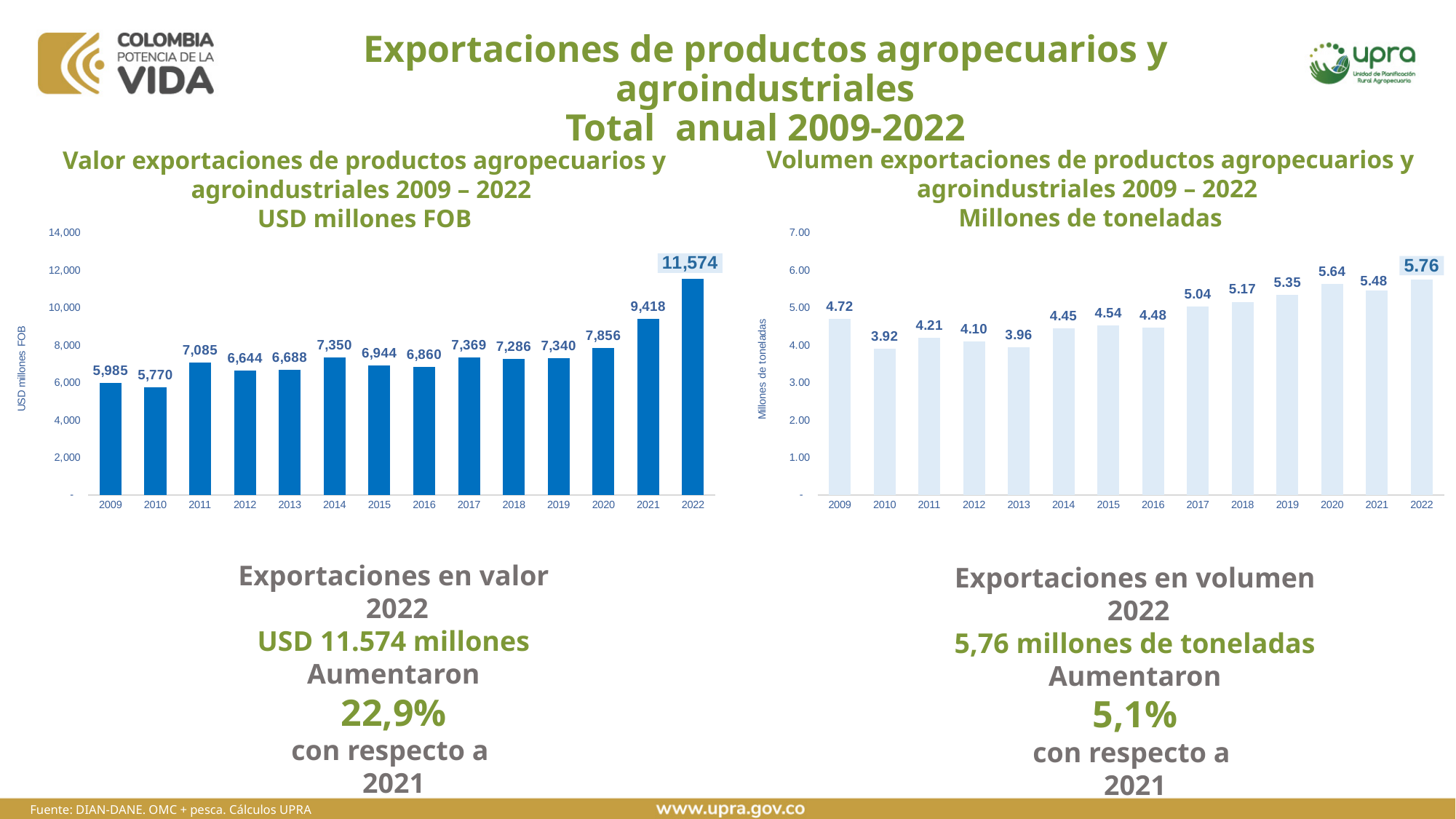
In the right chart (Volumen exportaciones), which is larger, the value for 2020 or the value for 2021? 2020 In the left chart (Valor exportaciones), which year has the lowest value? 2010 In the right chart (Volumen exportaciones), which year has the highest value? 2022 In the left chart (Valor exportaciones), what is the difference between the 2022 and 2021 values? 2,156 In the left chart (Valor exportaciones), how many years are plotted? 14 In the left chart (Valor exportaciones), what is the value for 2021? 9,418 In the left chart (Valor exportaciones), is the value for 2014 greater or less than 8,000? less In the right chart (Volumen exportaciones), what is the value for 2017? 5.04 What type of chart is the left chart (Valor exportaciones)? Bar chart In the right chart (Volumen exportaciones), which year has the lowest value? 2010 In the right chart (Volumen exportaciones), what is the difference between the 2022 and 2021 values? 0.28 What is the y-axis label of the right chart (Volumen exportaciones)? Millones de toneladas